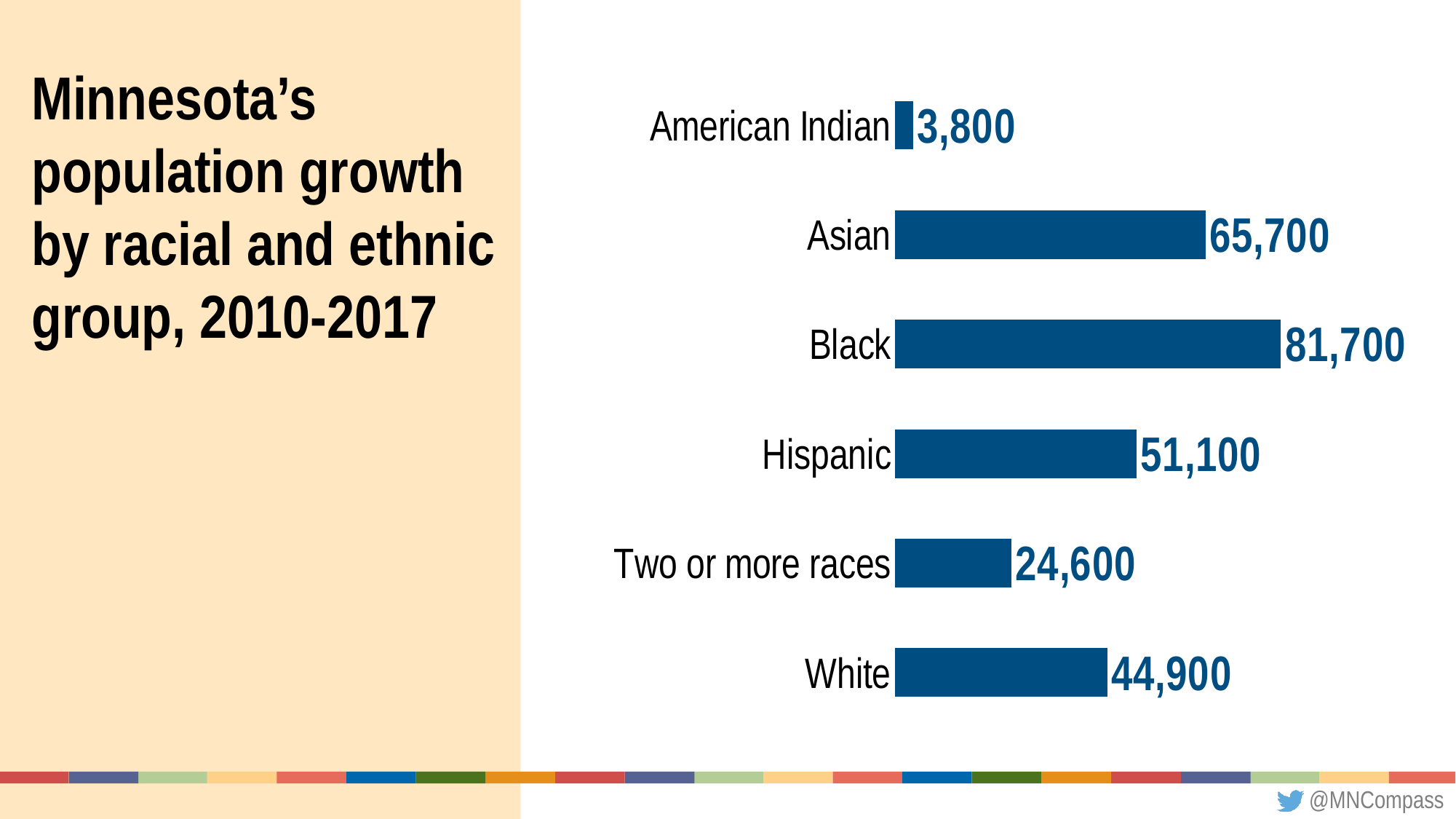
Which is larger, the population growth for Hispanic or for White? Hispanic Which group has the lowest population growth? American Indian Which group has the highest population growth? Black What is the title of the slide? Minnesota's population growth by racial and ethnic group, 2010-2017 Which is larger, the population growth for Two or more races or for American Indian? Two or more races What is the difference between the population growth for Hispanic and for White? 6,200 What is the population growth value for White? 44,900 How many racial and ethnic groups are shown in the chart? 6 What is the population growth value for Two or more races? 24,600 What kind of chart is shown on the slide? Bar chart What is the population growth value for Asian? 65,700 What is the difference between the population growth for Black and for Asian? 16,000